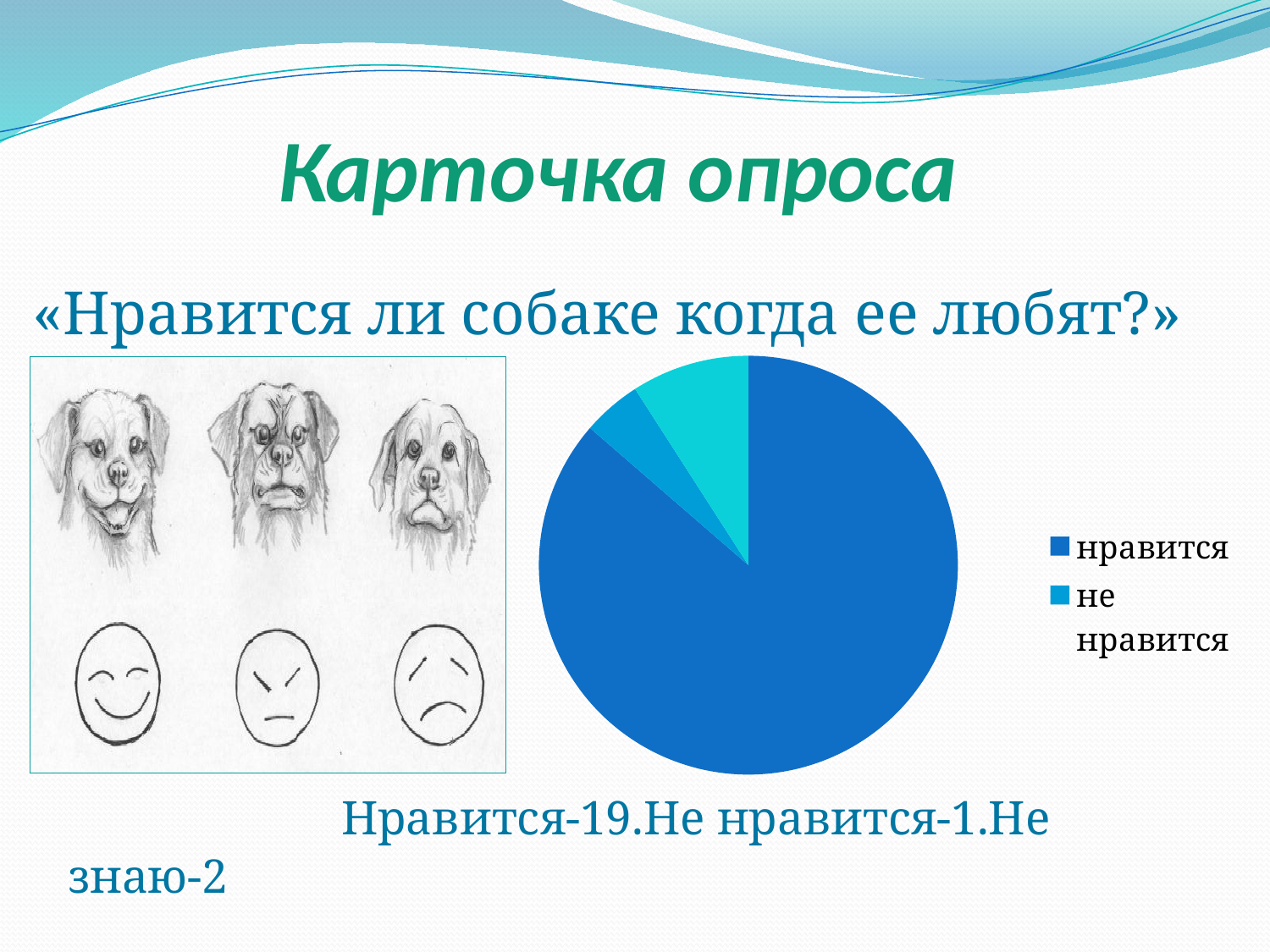
How many entries does the legend of the pie chart list? 2 According to the text under the pie chart, how many respondents answered «Не знаю»? 2 What is the difference between the number of «Нравится» and «Не нравится» answers? 18 What kind of chart is shown on the slide? pie chart Which category has the smallest slice in the pie chart? не нравится Which is larger: the «Нравится» slice or the «Не нравится» slice? нравится Which category has the largest slice in the pie chart? нравится How many slices does the pie chart have? 3 According to the text under the pie chart, how many respondents answered «Нравится»? 19 What colour is the «нравится» slice in the pie chart? dark blue What is the total number of responses shown for the pie chart? 22 According to the text under the pie chart, how many respondents answered «Не нравится»? 1